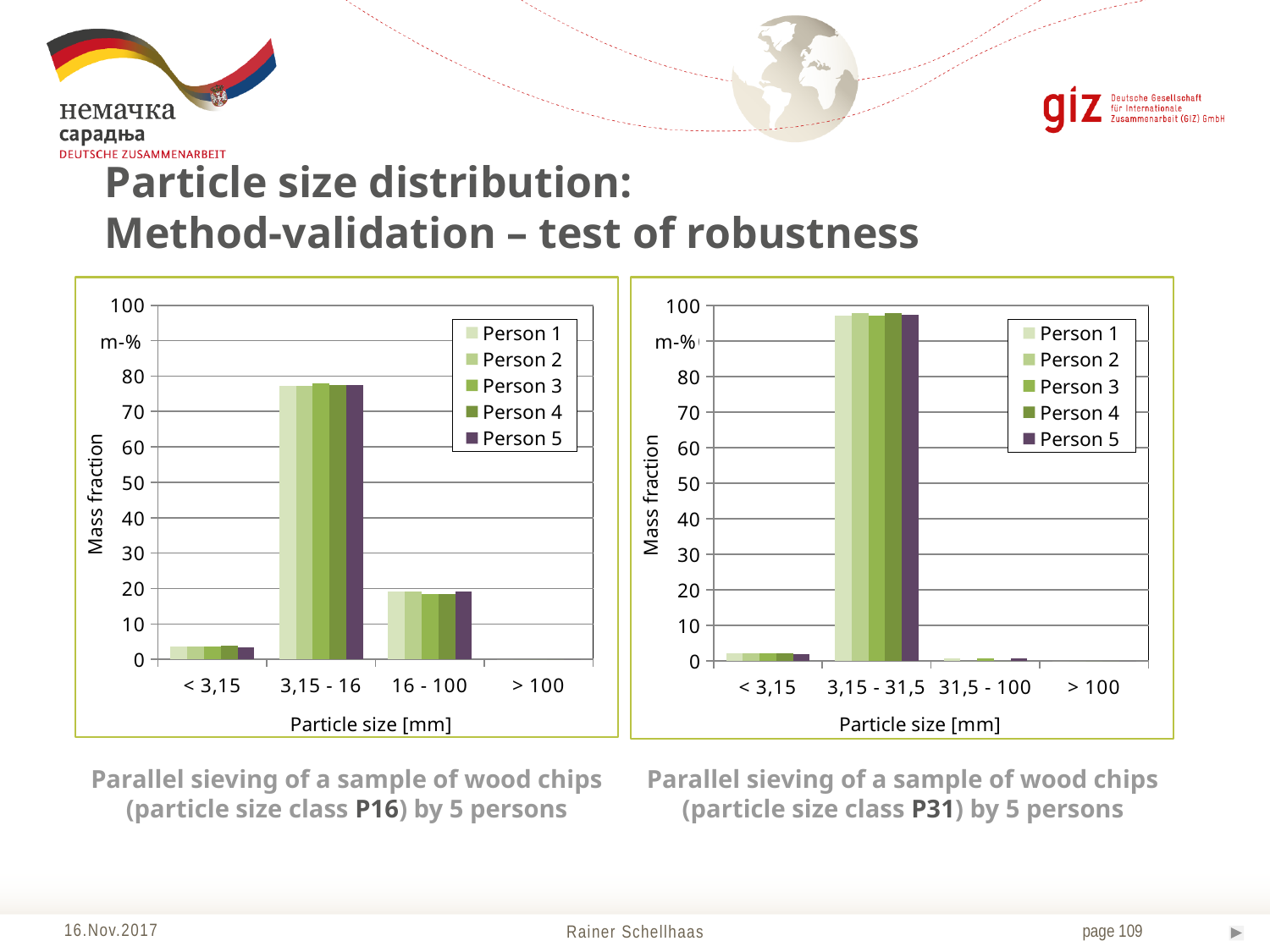
In the left chart (particle size class P16), which particle size category has the highest mass fraction? 3,15 - 16 In the right chart (particle size class P31), which particle size category has the highest mass fraction? 3,15 - 31,5 In the right chart (particle size class P31), how many series does the legend list? 5 In the right chart (particle size class P31), which is larger for Person 4: the value for < 3,15 or the value for 31,5 - 100? < 3,15 In the left chart (particle size class P16), which is larger for Person 3: the value for 16 - 100 or the value for < 3,15? 16 - 100 In the left chart (particle size class P16), how many particle size categories are shown on the x axis? 4 In the right chart (particle size class P31), is the value for Person 3 in the 3,15 - 31,5 category greater or less than 90? greater In the left chart (particle size class P16), what is the label of the y axis? Mass fraction In the right chart (particle size class P31), is the value for Person 2 in the < 3,15 category greater or less than 10? less In the left chart (particle size class P16), what kind of chart is shown? bar chart In the left chart (particle size class P16), is the value for Person 1 in the 3,15 - 16 category greater or less than 70? greater